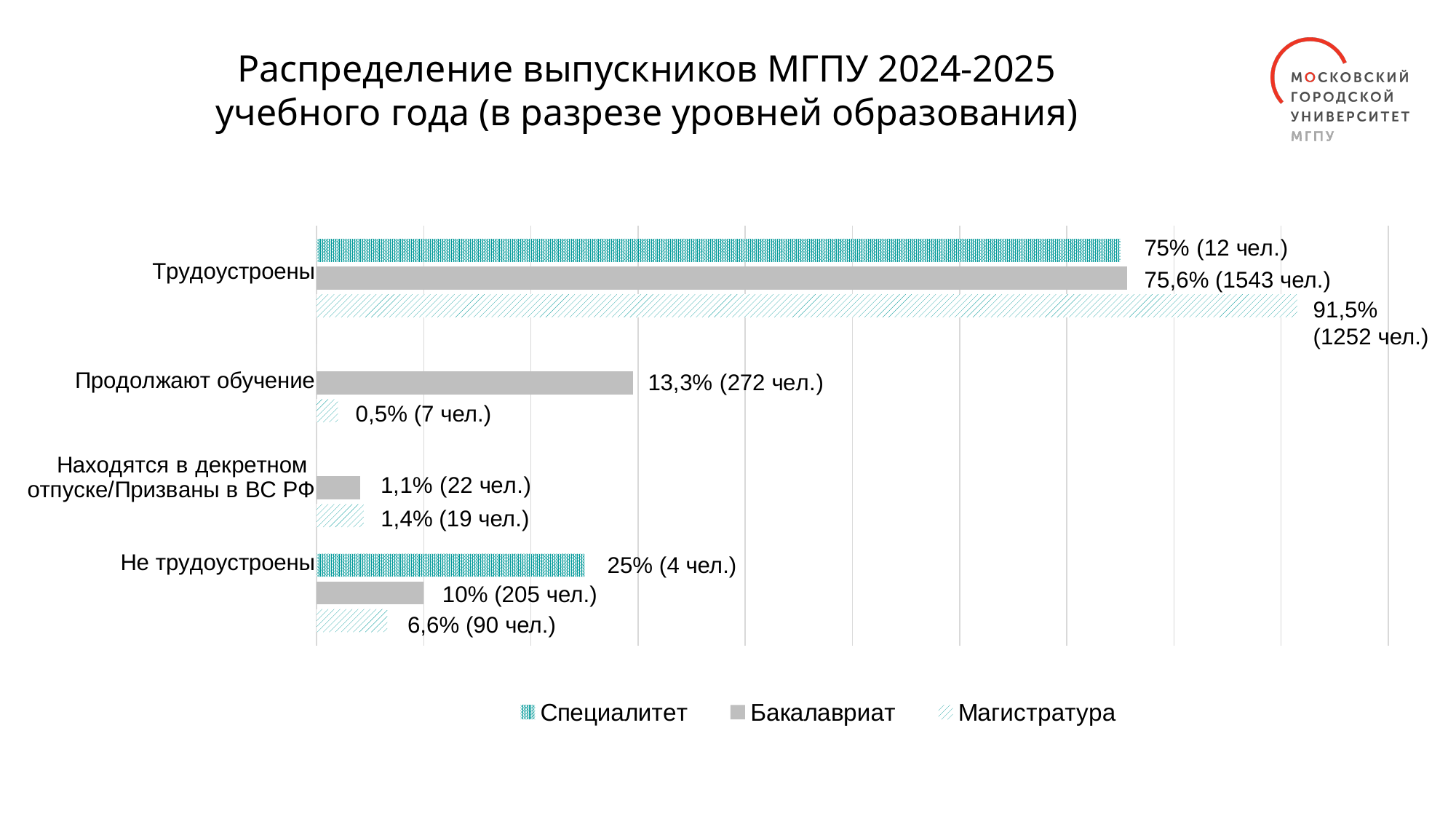
Какой тип диаграммы представлен на слайде? Столбчатая (bar chart) Сколько серий перечислено в легенде диаграммы? 3 Сколько категорий показано на диаграмме? 4 Сколько человек среди выпускников бакалавриата трудоустроены? 1543 чел. У какого уровня образования самая низкая доля не трудоустроенных выпускников? Магистратура У какого уровня образования самая высокая доля трудоустроенных выпускников? Магистратура Какой процент выпускников магистратуры трудоустроены? 91,5% Что больше: доля не трудоустроенных выпускников бакалавриата или магистратуры? Бакалавриат На сколько процентных пунктов доля трудоустроенных выпускников магистратуры больше, чем бакалавриата? 15,9 Сколько человек среди выпускников магистратуры не трудоустроены? 90 чел. Какой процент выпускников бакалавриата продолжают обучение? 13,3% Какой процент выпускников специалитета не трудоустроены? 25%